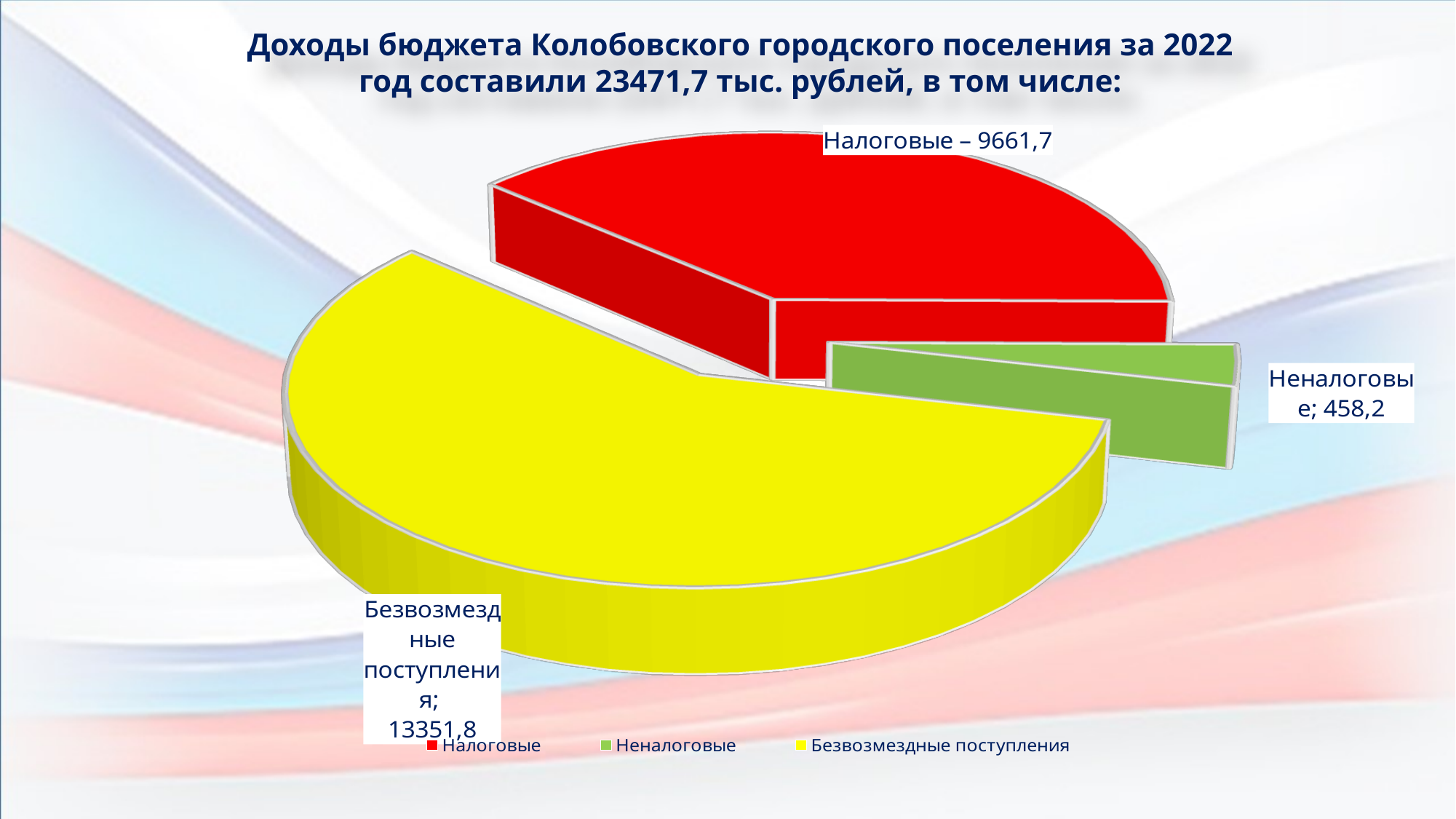
How many slices does the pie chart have? 3 What is the difference between the values for Безвозмездные поступления and Налоговые? 3690,1 Which category has the largest slice of the pie chart? Безвозмездные поступления What colour is the Безвозмездные поступления slice in the pie chart? Yellow What is the value for Налоговые in the pie chart? 9661,7 Which category has the smallest slice of the pie chart? Неналоговые What is the total of all three slices of the pie chart, as stated in the slide title? 23471,7 тыс. рублей Which is larger, the value for Налоговые or the value for Неналоговые? Налоговые What is the value for Безвозмездные поступления in the pie chart? 13351,8 What is the difference between the values for Налоговые and Неналоговые? 9203,5 What is the value for Неналоговые in the pie chart? 458,2 What kind of chart is shown on the slide? Pie chart